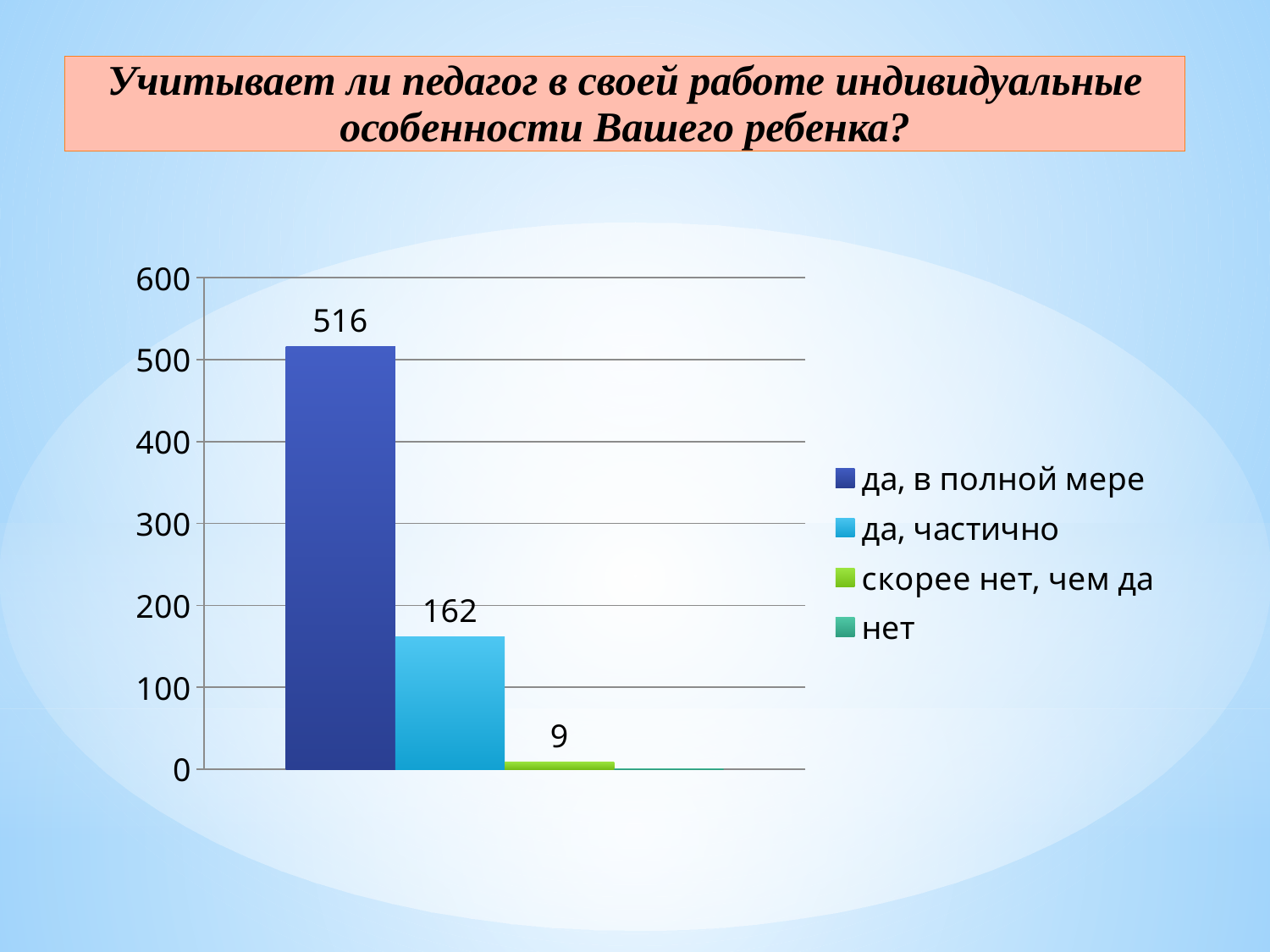
How many series does the legend list? 4 What is the difference between the values for "да, частично" and "скорее нет, чем да"? 153 What kind of chart is shown on the slide? bar chart Which response has the highest value? да, в полной мере Is the value for "да, в полной мере" greater or less than 500? greater What value is shown for "скорее нет, чем да"? 9 What is the difference between the values for "да, в полной мере" and "да, частично"? 354 What value is shown for "да, в полной мере"? 516 Which response has the lowest value? нет Is the value for "да, частично" greater or less than 200? less Which is larger, the value for "да, частично" or the value for "скорее нет, чем да"? да, частично What value is shown for "да, частично"? 162